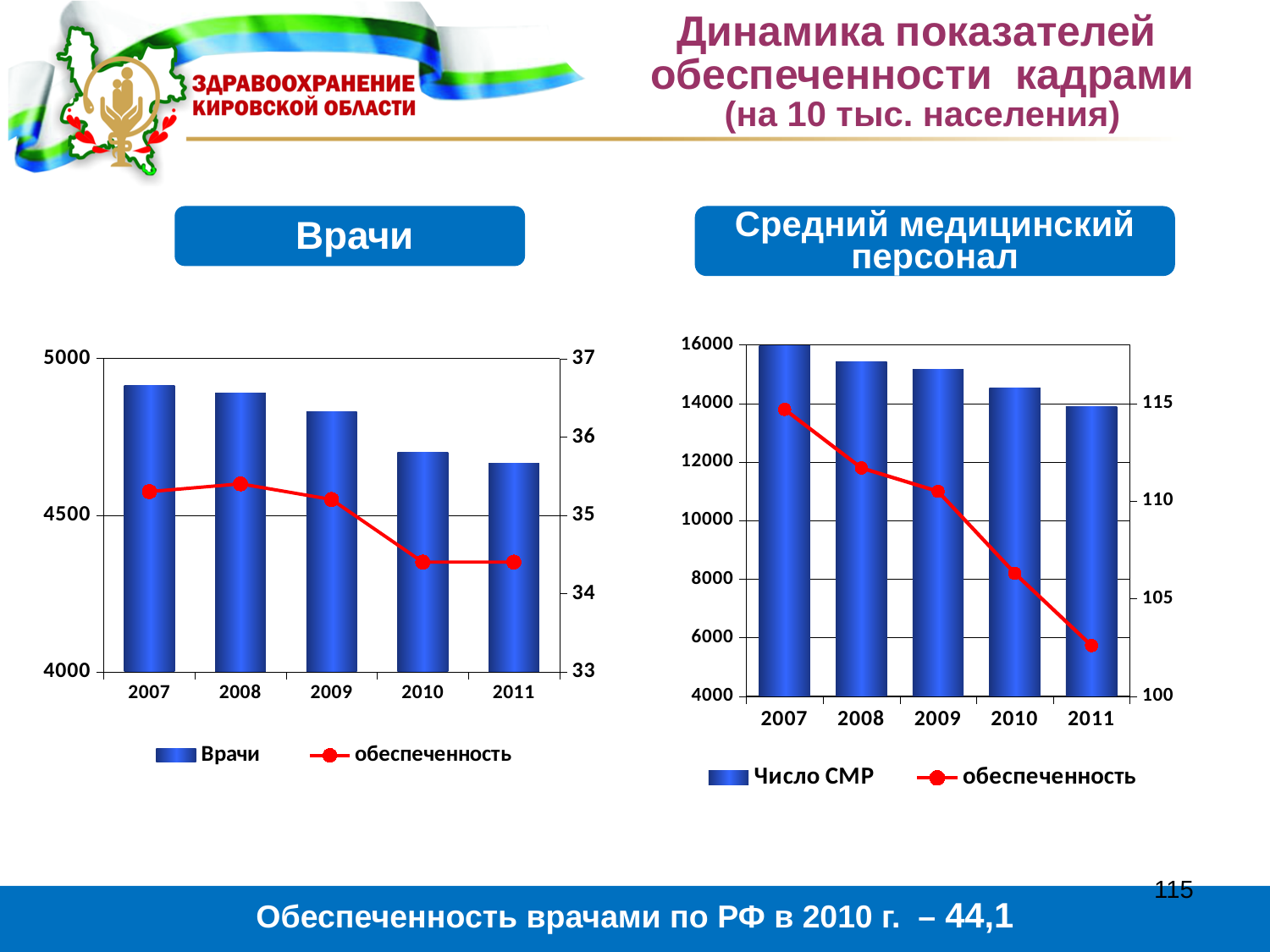
In the 'Врачи' chart, how many years are shown on the x axis? 5 In the 'Средний медицинский персонал' chart, what are the two legend entries? Число СМР and обеспеченность In the 'Врачи' chart, which year has the lowest bar? 2011 In the 'Средний медицинский персонал' chart, do the bars rise or fall from 2007 to 2011? fall In the 'Врачи' chart, is the 'обеспеченность' value for 2011 greater or less than 35? less In the 'Врачи' chart, which year has the highest bar? 2007 In the 'Средний медицинский персонал' chart, is the 'обеспеченность' value for 2010 greater or less than 105? greater In the 'Средний медицинский персонал' chart, which year has the lowest 'обеспеченность' value? 2011 In the 'Врачи' chart, is the bar for 2010 greater or less than 4500? greater In the 'Средний медицинский персонал' chart, which bar is taller, 2008 or 2011? 2008 In the 'Врачи' chart, what kind of chart is used to show the 'Врачи' series? bar chart In the 'Врачи' chart, how many series does the legend list? 2